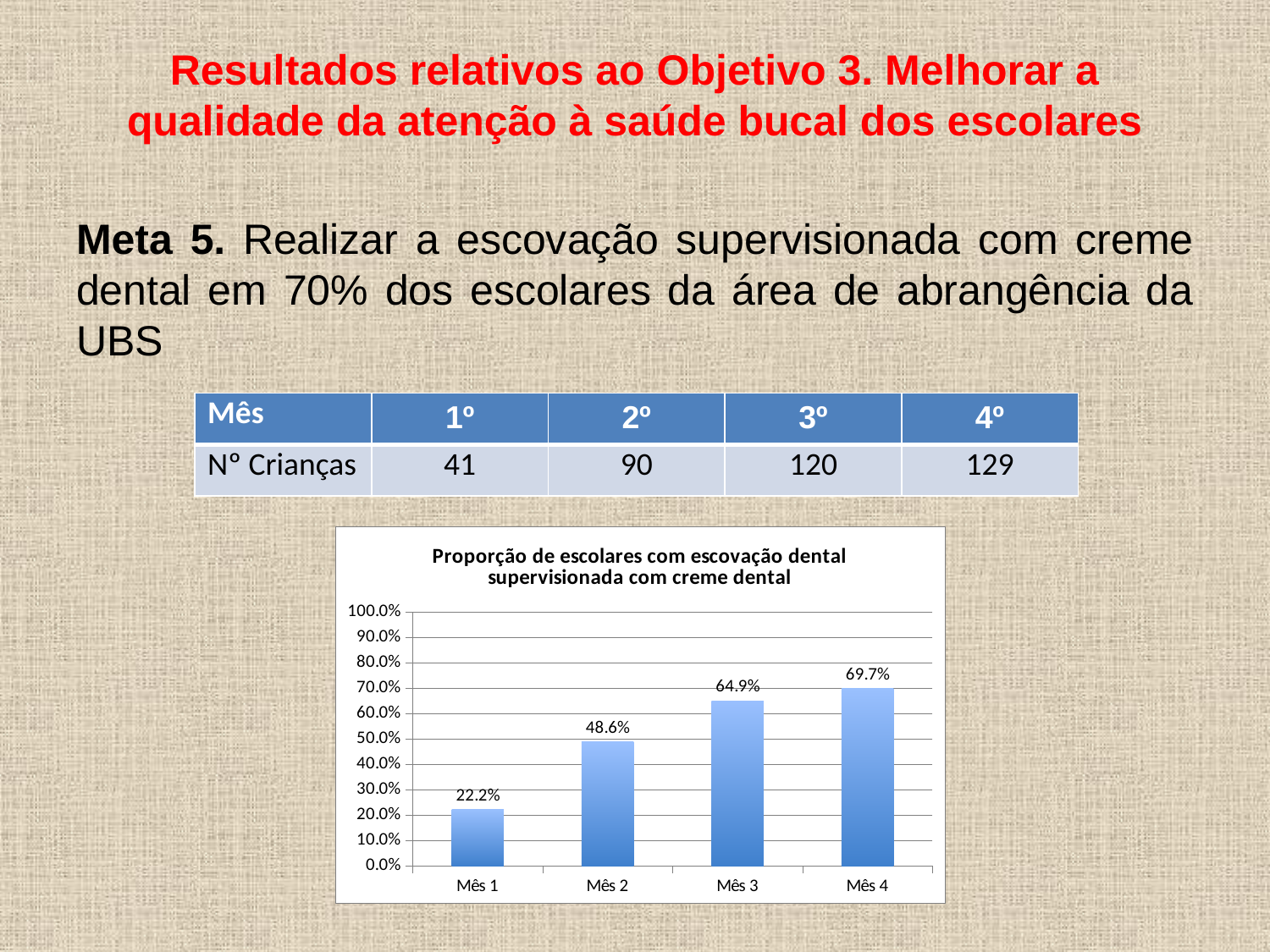
Which is larger, the value for Mês 2 or the value for Mês 3? Mês 3 What kind of chart is shown on the slide? Bar chart Which month has the highest proportion in the chart? Mês 4 What is the difference between the values for Mês 2 and Mês 1? 26.4% Which month has the lowest proportion in the chart? Mês 1 How many bars are plotted in the chart? 4 What is the value for Mês 3 in the chart? 64.9% What is the value for Mês 4 in the chart? 69.7% What is the difference between the values for Mês 4 and Mês 3? 4.8% What is the value for Mês 2 in the chart? 48.6% What is the value for Mês 1 in the chart? 22.2% Do the values rise or fall from Mês 1 to Mês 4? Rise